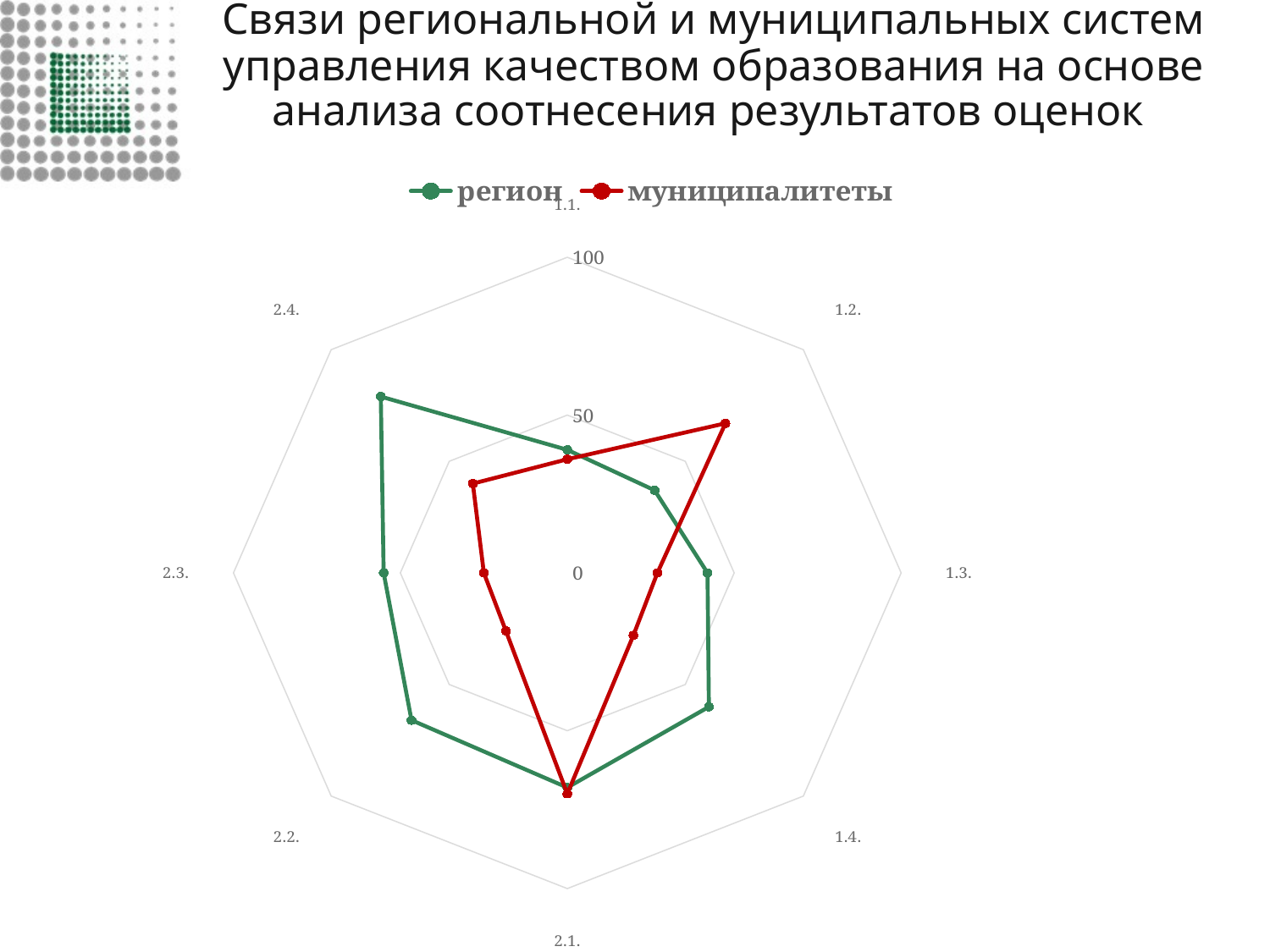
How many categories (axes) does the radar chart have? 8 Is the value for муниципалитеты at 2.3. greater or less than 50? less What kind of chart is shown on the slide? radar chart Is the value for регион at 2.4. greater or less than 50? greater At category 1.2., which series has the larger value, регион or муниципалитеты? муниципалитеты Is the value for муниципалитеты at 1.2. greater or less than 50? greater Which series is drawn in green? регион At category 2.2., which series has the larger value, регион or муниципалитеты? регион Which category has the highest value for the регион series? 2.4. How many series does the legend list? 2